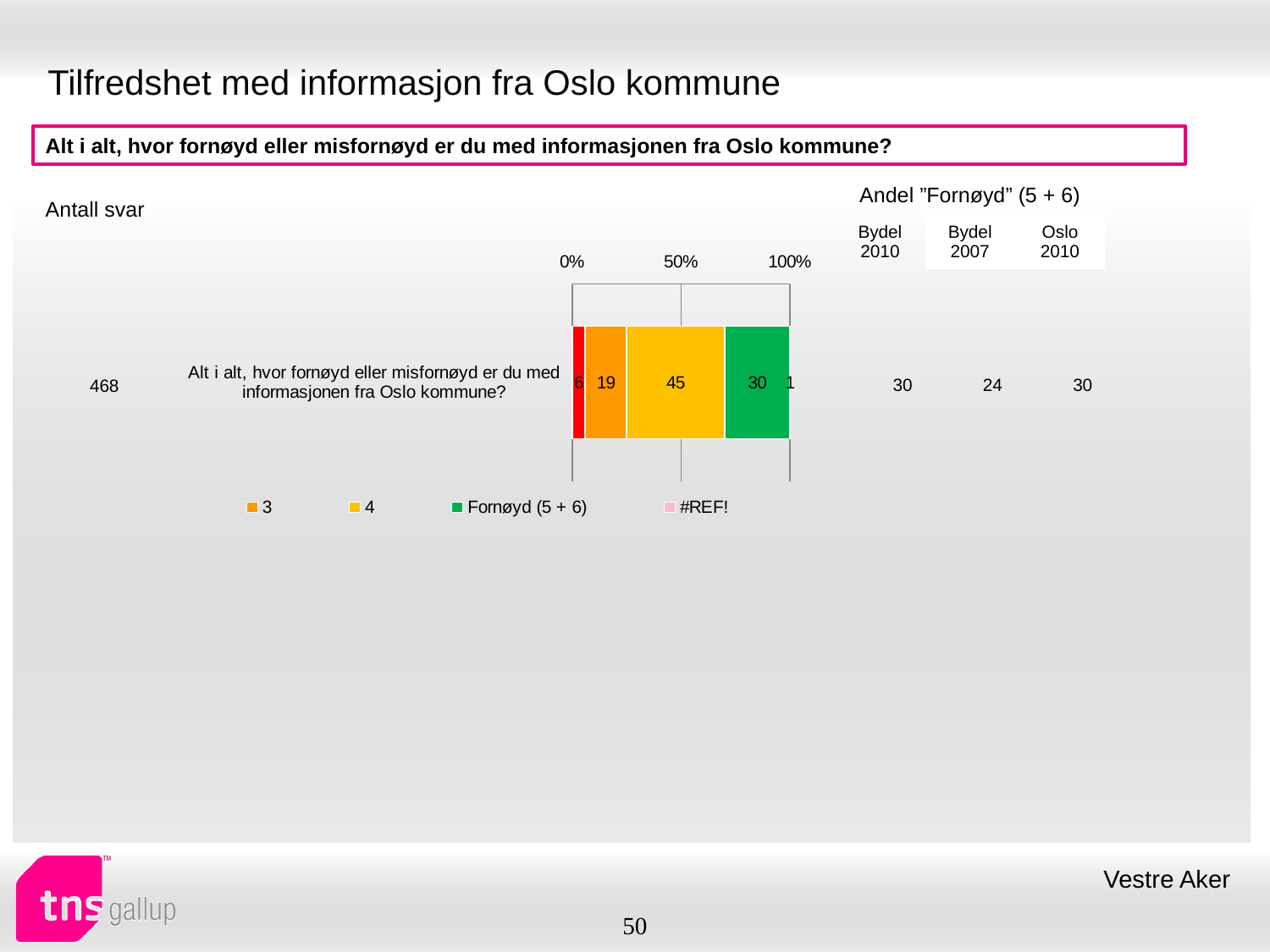
What colour is used for the "Fornøyd (5 + 6)" series in the chart? Green What is the value of the "Fornøyd (5 + 6)" segment in the stacked bar? 30 Which legend series has the smallest segment in the stacked bar? #REF! What is the value of the segment for series "3" in the stacked bar? 19 Which is larger: the segment for series "3" or the "Fornøyd (5 + 6)" segment? Fornøyd (5 + 6) What is the value of the segment for series "4" in the stacked bar? 45 What kind of chart is shown on the slide? Stacked bar chart Which legend series has the largest segment in the stacked bar? 4 What is the difference between the segment for series "4" and the "Fornøyd (5 + 6)" segment? 15 How many series does the chart legend list? 4 How many bars (categories) does the chart contain? 1 What is the value of the "#REF!" segment in the stacked bar? 1